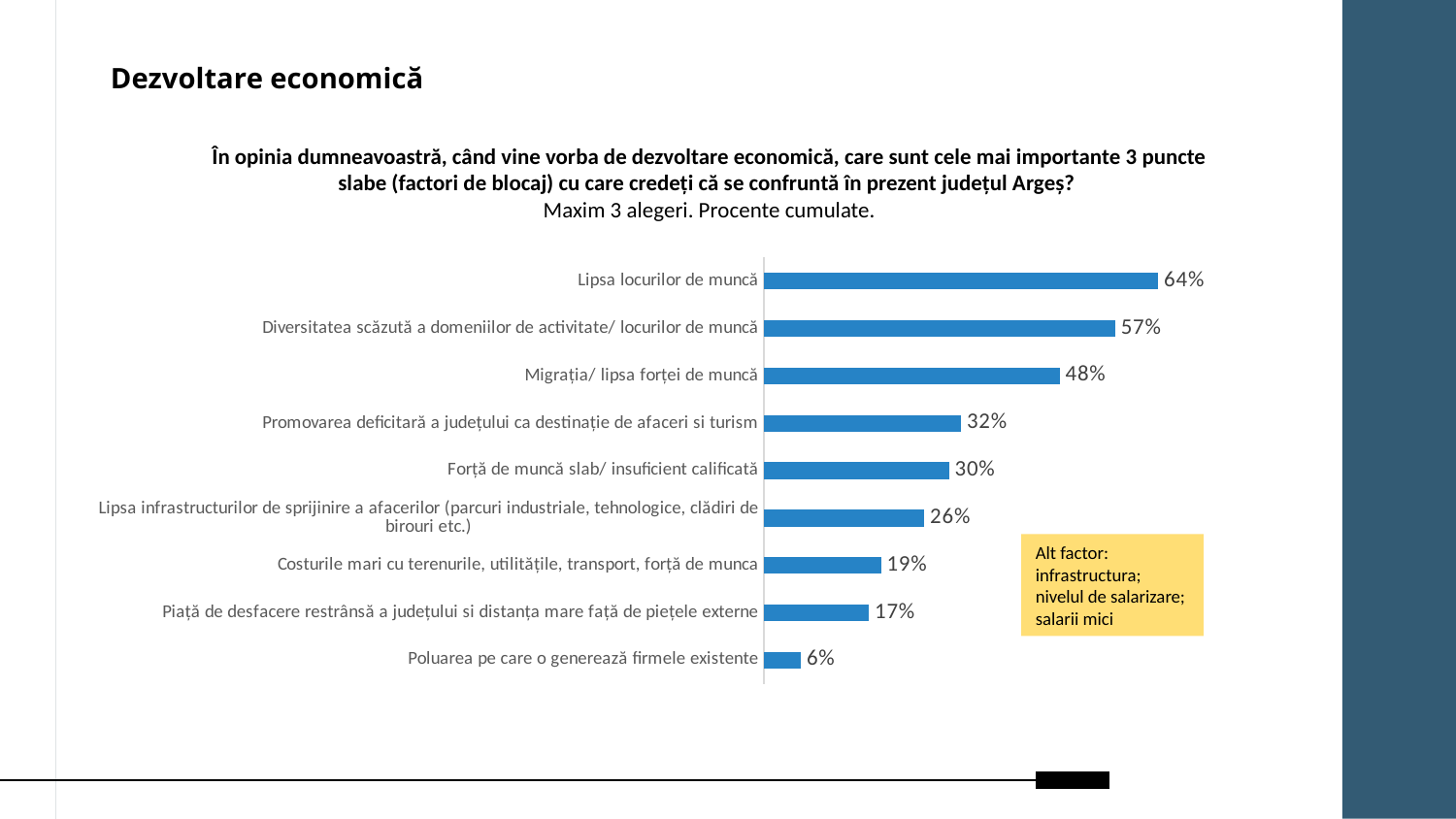
What is the value for "Poluarea pe care o generează firmele existente"? 6% What is the value for "Costurile mari cu terenurile, utilitățile, transport, forță de munca"? 19% What kind of chart is shown on the slide? Bar chart What is the value for "Lipsa locurilor de muncă"? 64% Which is larger: "Promovarea deficitară a județului ca destinație de afaceri si turism" or "Forță de muncă slab/ insuficient calificată"? Promovarea deficitară a județului ca destinație de afaceri si turism What is the difference between "Lipsa locurilor de muncă" and "Diversitatea scăzută a domeniilor de activitate/ locurilor de muncă"? 7% Which category has the highest value? Lipsa locurilor de muncă How many categories are shown in the chart? 9 What is the value for "Migrația/ lipsa forței de muncă"? 48% What is the difference between "Piață de desfacere restrânsă a județului si distanța mare față de piețele externe" and "Poluarea pe care o generează firmele existente"? 11% Which category has the lowest value? Poluarea pe care o generează firmele existente What colour are the bars in the chart? Blue